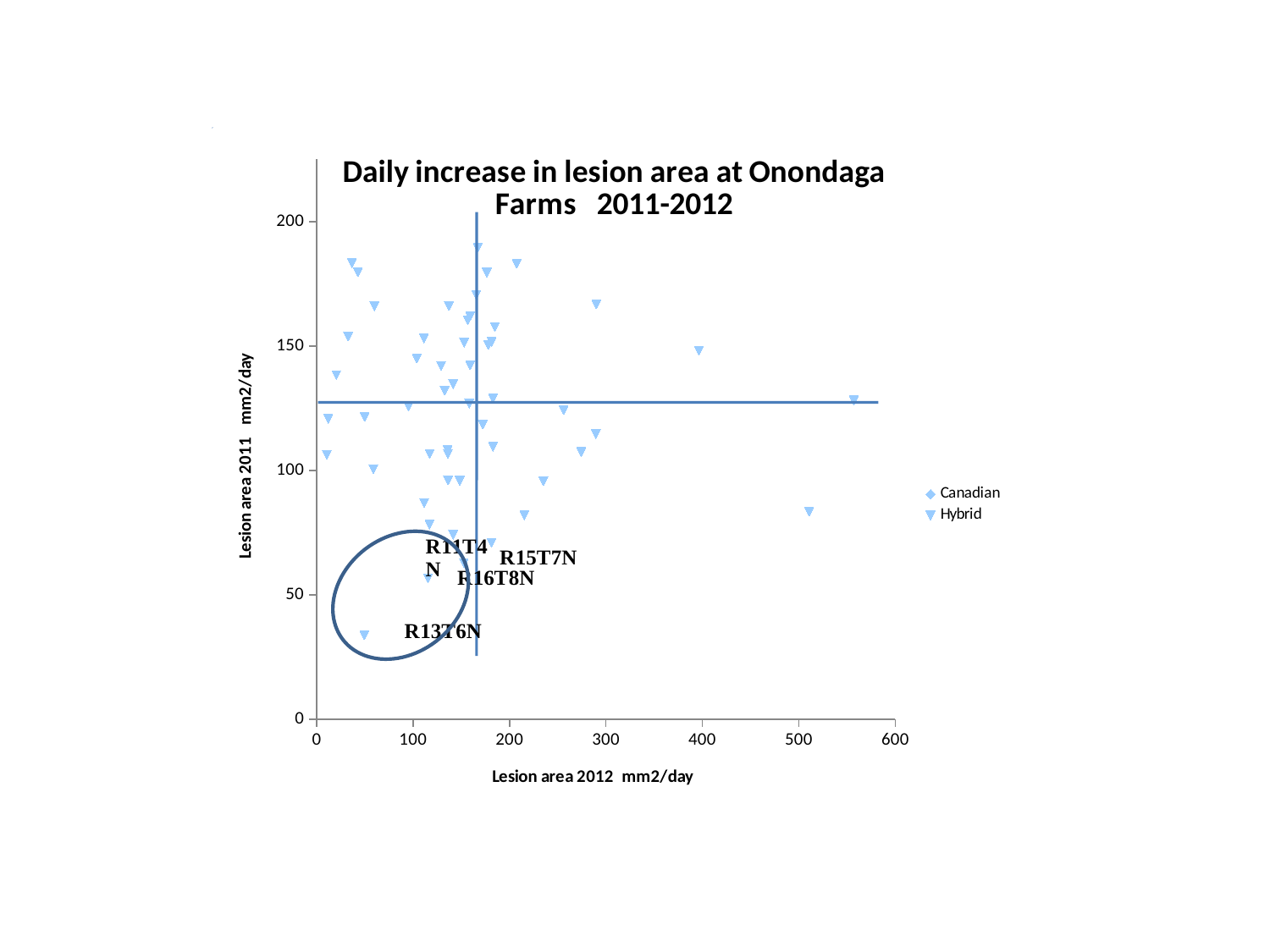
What is the title of the chart? Daily increase in lesion area at Onondaga Farms 2011-2012 What is the maximum value shown on the y axis? 200 How many series does the legend list? 2 What is the label of the y axis? Lesion area 2011 mm2/day What are the two series named in the legend? Canadian and Hybrid Is the highest Lesion area 2011 value plotted greater or less than 150? greater What is the maximum value shown on the x axis? 600 Is the lowest Lesion area 2011 value plotted greater or less than 50? less How many points are labelled with names inside or near the circled region? 4 What kind of chart is shown on the slide? Scatter chart Is the largest Lesion area 2012 value plotted greater or less than 500? greater What is the label of the x axis? Lesion area 2012 mm2/day